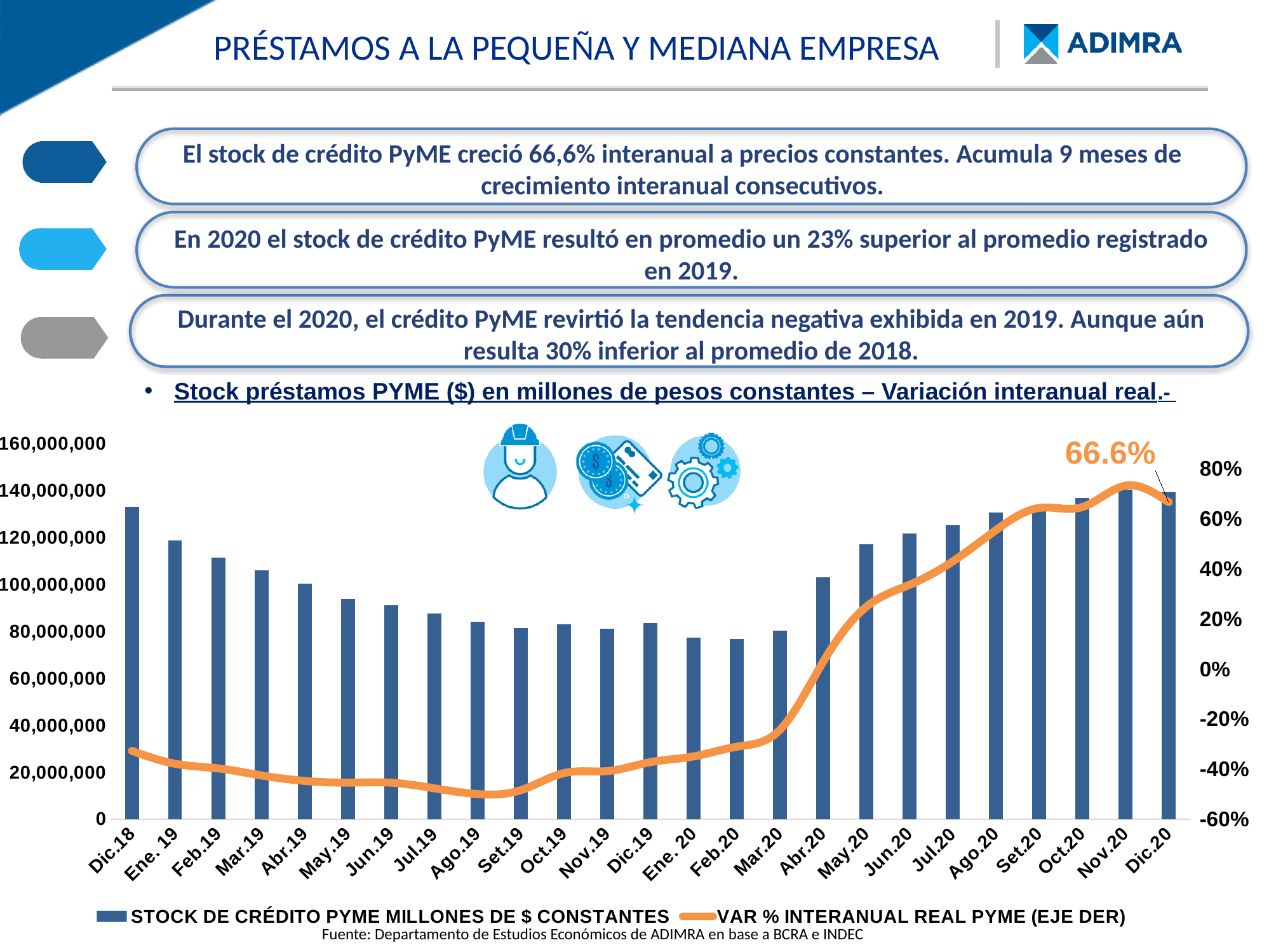
Does the year-on-year variation line rise or fall from Mar.20 to Nov.20? Rise Is the stock of PyME credit for Dic.18 greater or less than 120,000,000? greater In which month does the year-on-year variation line reach its highest point? Nov.20 What colour is the VAR % INTERANUAL REAL PYME line? Orange Is the year-on-year variation (orange line) for Ago.19 greater or less than -40%? less Which is larger, the stock of PyME credit in Dic.18 or in Dic.19? Dic.18 What kind of chart is used for the STOCK DE CRÉDITO PYME series? Bar chart What is the year-on-year real variation (VAR % INTERANUAL REAL PYME) shown for Dic.20? 66.6% How many months (categories) are plotted along the x axis? 25 How many series does the chart legend list? 2 Is the stock of PyME credit for Mar.20 greater or less than 100,000,000? less Do the stock bars rise or fall from Dic.18 to Ago.19? Fall